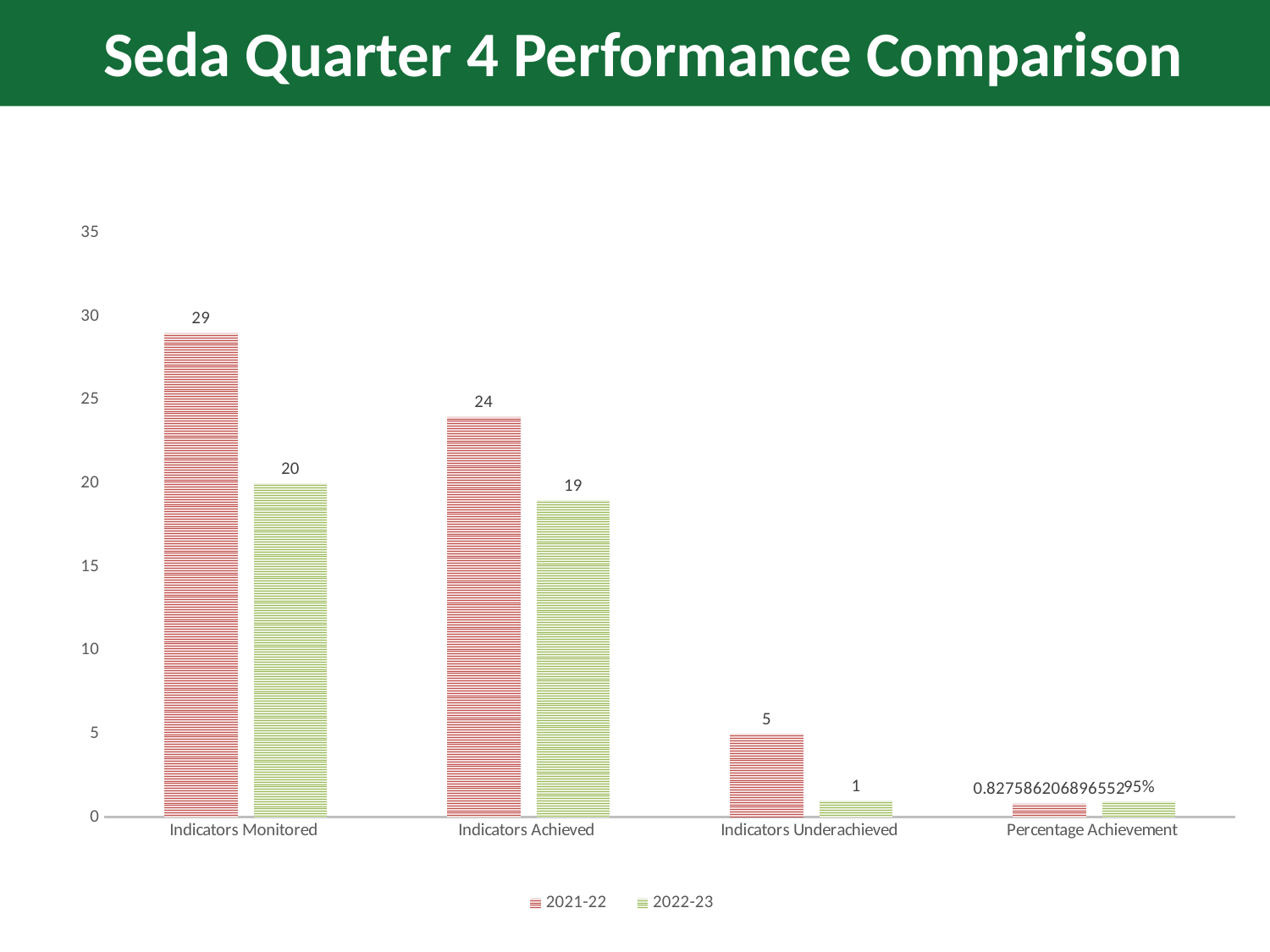
Which category has the highest value in the 2021-22 series? Indicators Monitored What is the value for Indicators Monitored in the 2021-22 series? 29 What is the value for Indicators Achieved in the 2022-23 series? 19 What is the value for Indicators Monitored in the 2022-23 series? 20 What is the value for Indicators Underachieved in the 2021-22 series? 5 How many series does the legend list? 2 Which is larger for Indicators Monitored: the 2021-22 value or the 2022-23 value? 2021-22 How many categories are shown on the x axis? 4 What is the difference between the 2021-22 and 2022-23 values for Indicators Underachieved? 4 What is the difference between the 2021-22 and 2022-23 values for Indicators Achieved? 5 What is the title of the slide? Seda Quarter 4 Performance Comparison What kind of chart is shown on the slide? Bar chart